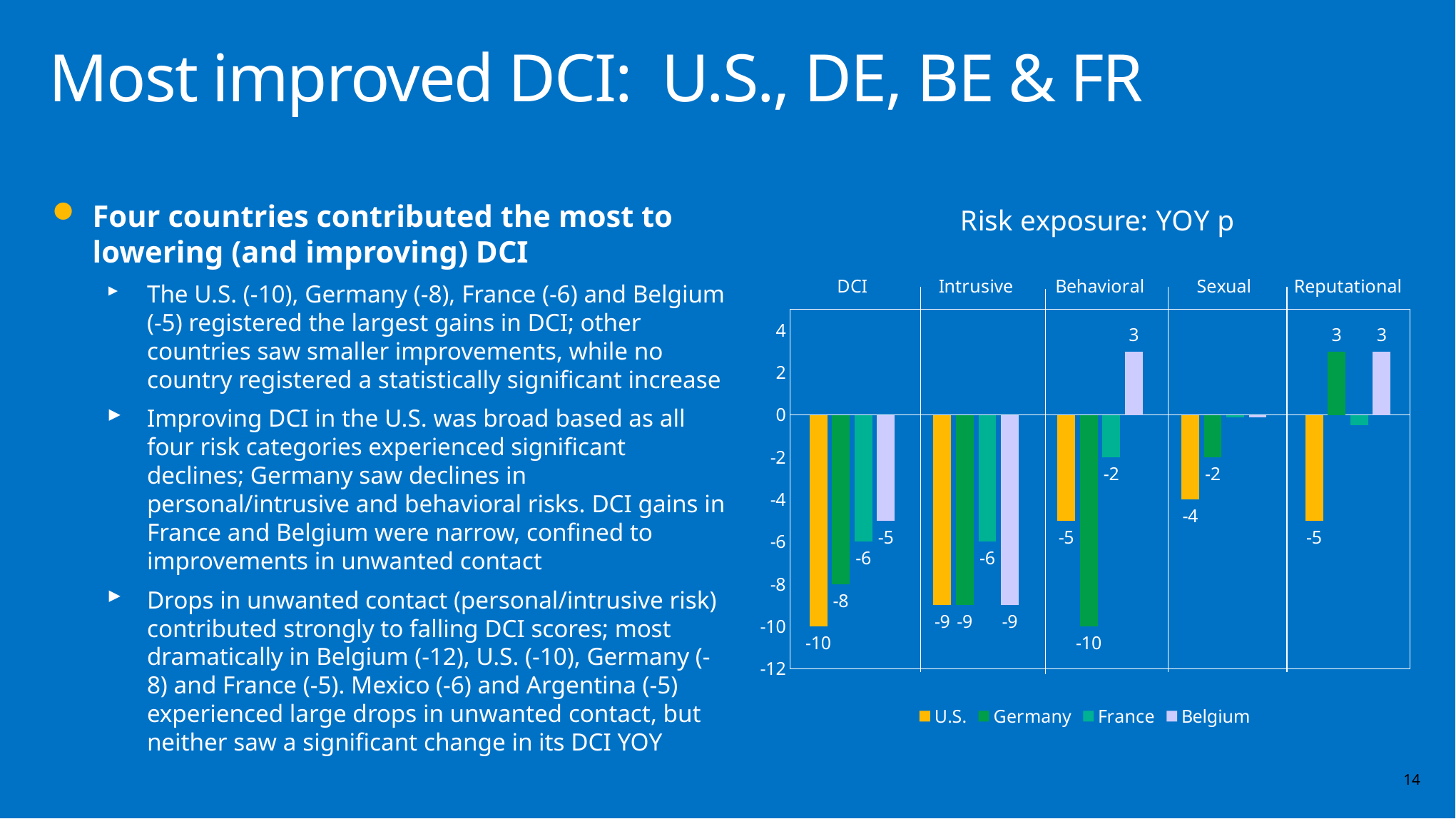
What is the value for Germany in the Behavioral category? -10 What is the value for U.S. in the Sexual category? -4 What is the value for Belgium in the Behavioral category? 3 How many risk categories are shown on the x axis? 5 What kind of chart is shown on the slide? Bar chart What is the value for Germany in the Reputational category? 3 What is the value for U.S. in the DCI category? -10 What is the difference between the U.S. and Belgium values in the DCI category? 5 Which country has the highest value in the Behavioral category? Belgium How many series does the legend list? 4 Which country has the lowest value in the DCI category? U.S. In the Intrusive category, which is larger: the value for France or the value for Belgium? France